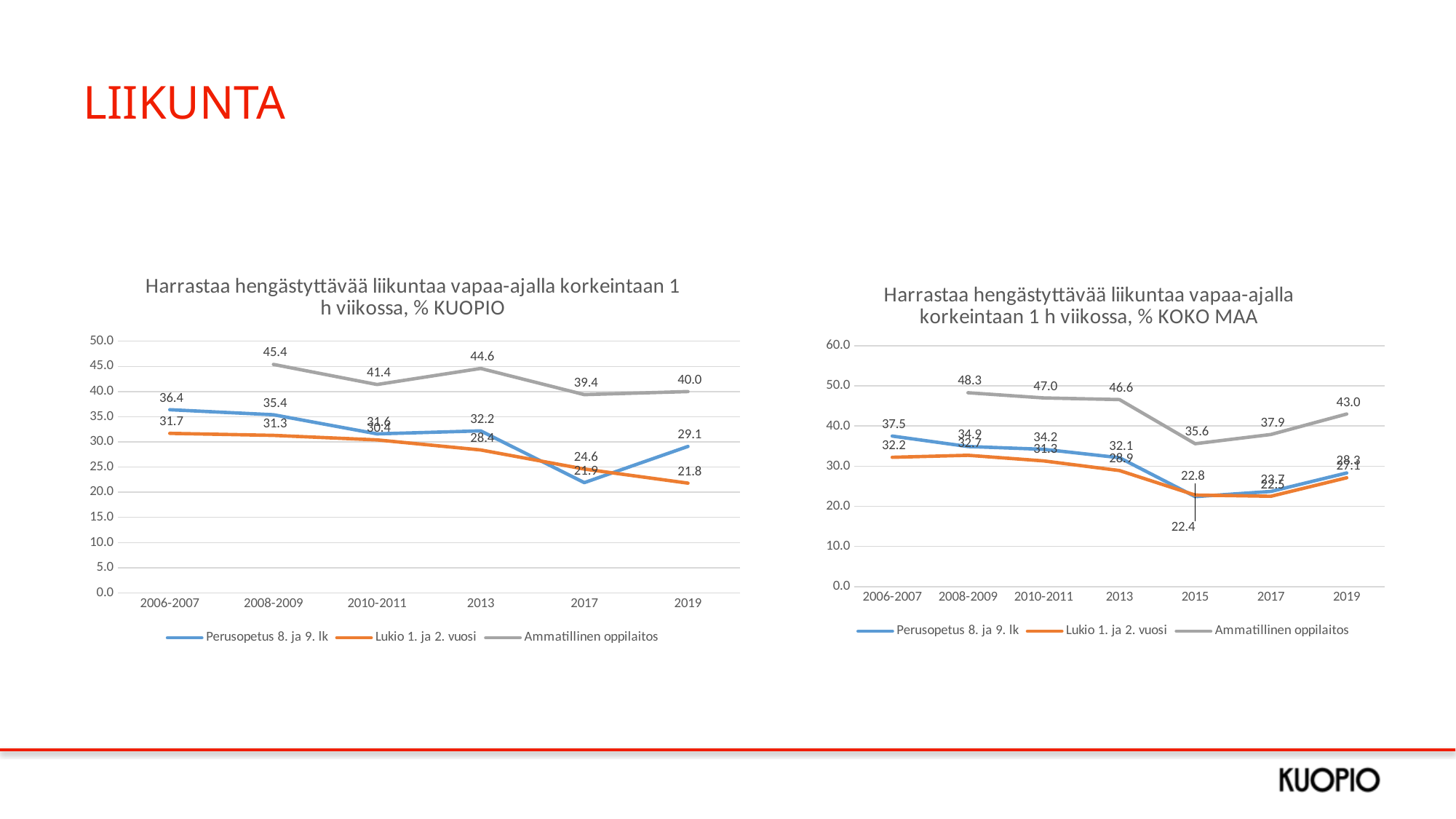
In the right chart (KOKO MAA), which is larger in 2006-2007: Perusopetus 8. ja 9. lk or Lukio 1. ja 2. vuosi? Perusopetus 8. ja 9. lk What kind of chart is the right chart (KOKO MAA)? Line chart In the right chart (KOKO MAA), what is the value for Ammatillinen oppilaitos in 2015? 35.6 How many time periods are shown on the x axis of the left chart (KUOPIO)? 6 In the left chart (KUOPIO), what is the value for Lukio 1. ja 2. vuosi in 2019? 21.8 In the left chart (KUOPIO), in which year is the Ammatillinen oppilaitos value highest? 2008-2009 In the right chart (KOKO MAA), does the Ammatillinen oppilaitos value rise or fall from 2008-2009 to 2015? Fall In the left chart (KUOPIO), in which year is the Perusopetus 8. ja 9. lk value lowest? 2017 In the left chart (KUOPIO), what is the value for Ammatillinen oppilaitos in 2008-2009? 45.4 In the left chart (KUOPIO), what is the difference between Ammatillinen oppilaitos and Perusopetus 8. ja 9. lk in 2019? 10.9 How many series does the legend of the right chart (KOKO MAA) list? 3 In the left chart (KUOPIO), what is the value for Perusopetus 8. ja 9. lk in 2017? 21.9